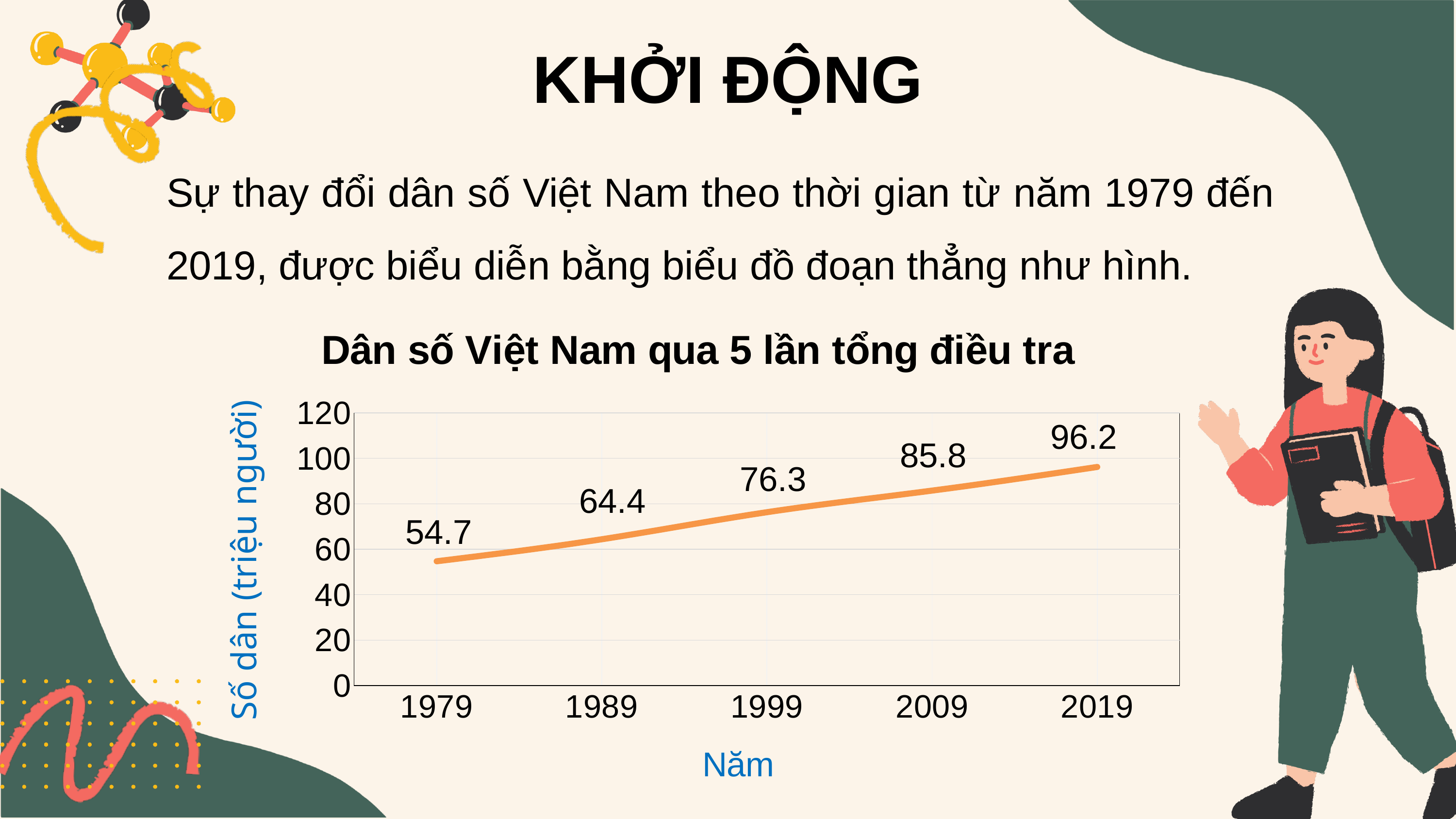
Is the value for 2009 greater or less than 80? greater Which year has the lowest population value? 1979 What is the population value shown for 2019? 96.2 What is the difference between the population values for 2019 and 1979? 41.5 What is the population value shown for 1999? 76.3 Which year has the highest population value? 2019 How many years are plotted on the chart? 5 What kind of chart is shown on the slide? line chart What is the population value shown for 1979? 54.7 Do the values rise or fall from 1979 to 2019? rise Which is larger, the value for 1989 or the value for 2009? 2009 What is the difference between the population values for 2009 and 1989? 21.4